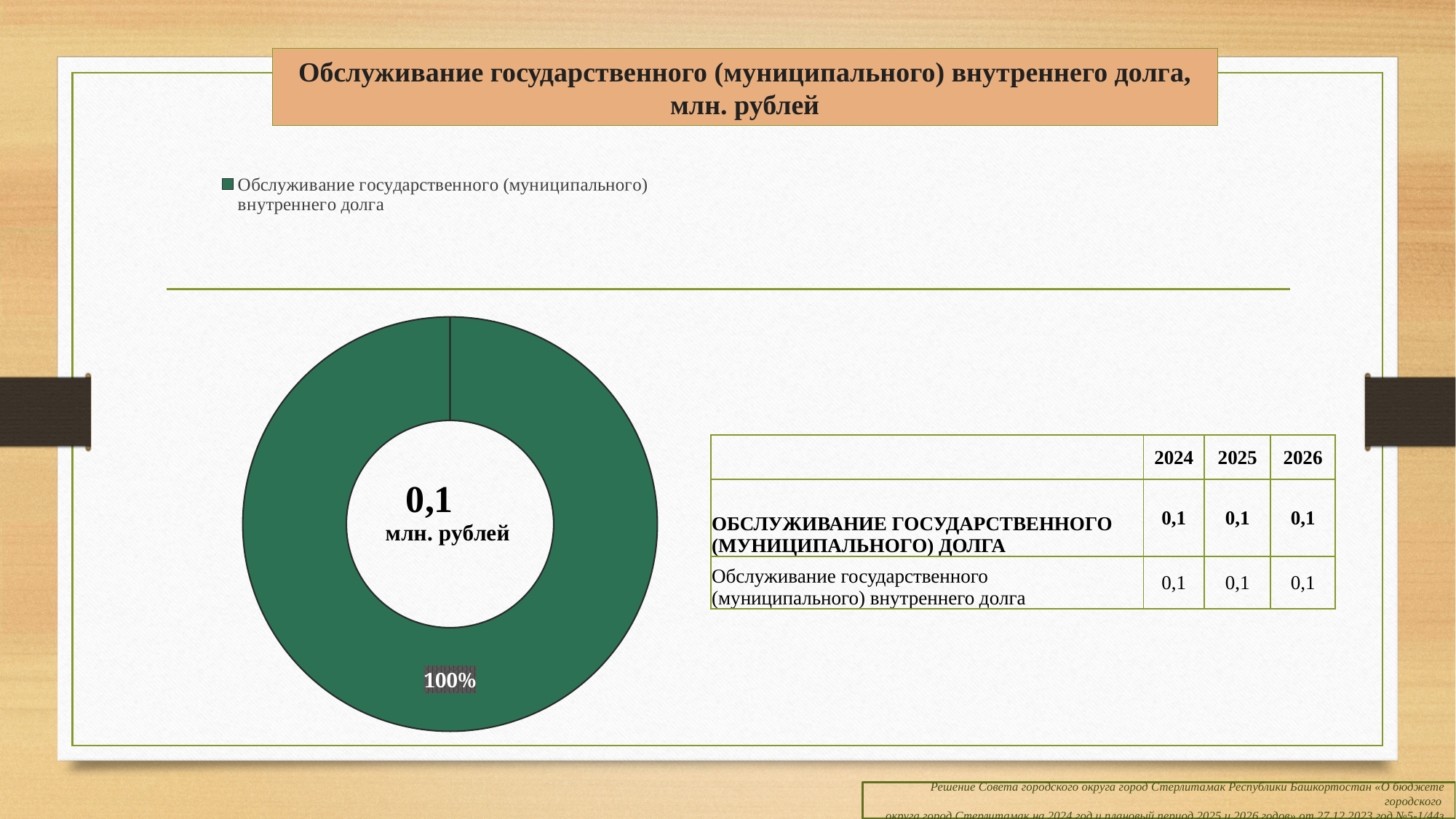
What is the title of the chart on the slide? Обслуживание государственного (муниципального) внутреннего долга, млн. рублей What value is printed in the centre of the doughnut chart? 0,1 млн. рублей What share of the doughnut chart does the slice "Обслуживание государственного (муниципального) внутреннего долга" take? 100% What kind of chart is shown on the slide? Doughnut (pie) chart In what units are the values of the chart expressed, according to the chart title? млн. рублей How many slices does the doughnut chart have? 1 What percentage label is shown on the single slice of the doughnut chart? 100% How many entries does the chart legend list? 1 What is the legend entry of the doughnut chart? Обслуживание государственного (муниципального) внутреннего долга